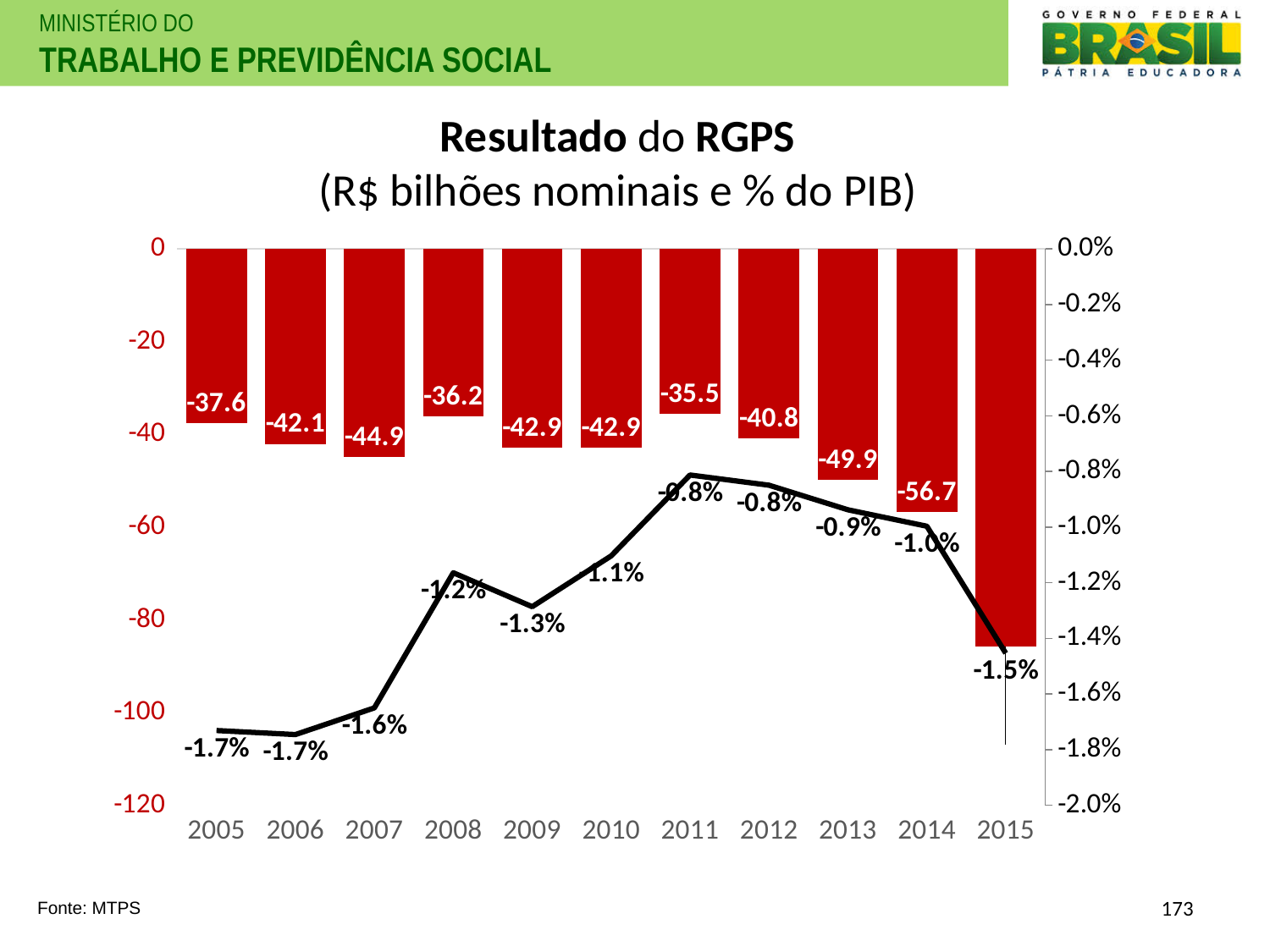
What is the value of the line (% do PIB) for 2011? -0.8% Among the labelled bars, which year has the value closest to zero? 2011 Which year has the more negative bar value, 2006 or 2007? 2007 What is the value of the line (% do PIB) for 2015? -1.5% Which year has the bar with the largest negative value (the longest bar)? 2015 What is the value of the bar for 2014? -56.7 What is the difference between the bar values for 2014 and 2013? 6.8 Does the line (% do PIB) rise or fall from 2005 to 2011? Rises What is the value of the bar for 2008? -36.2 What kind of chart is this? Combined bar and line chart Is the bar value for 2015 greater or less than -80? less How many years are shown on the x axis? 11